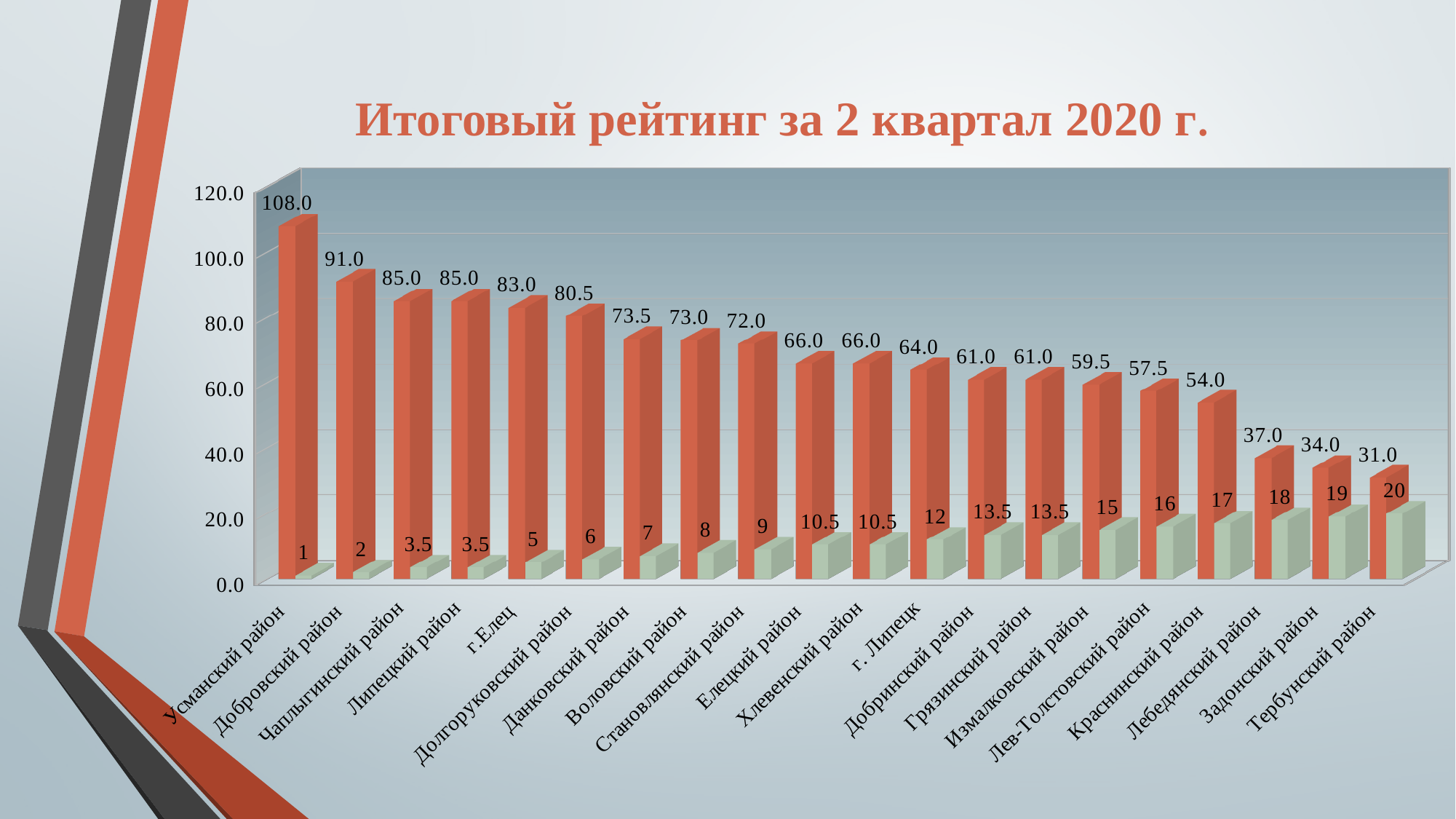
What is the score value shown for Усманский район? 108.0 How many categories are shown on the x axis? 20 Do the score values rise or fall from left to right along the x axis? Fall What is the title of the chart? Итоговый рейтинг за 2 квартал 2020 г. What kind of chart is shown on the slide? Bar chart What is the score value shown for г. Липецк? 64.0 What is the difference between the scores of Добровский район and Краснинский район? 37.0 Which category has the highest score? Усманский район Which has a higher score, Данковский район or Лебедянский район? Данковский район Which category has the lowest score? Тербунский район What is the score value shown for Тербунский район? 31.0 What rank number is shown for Долгоруковский район? 6